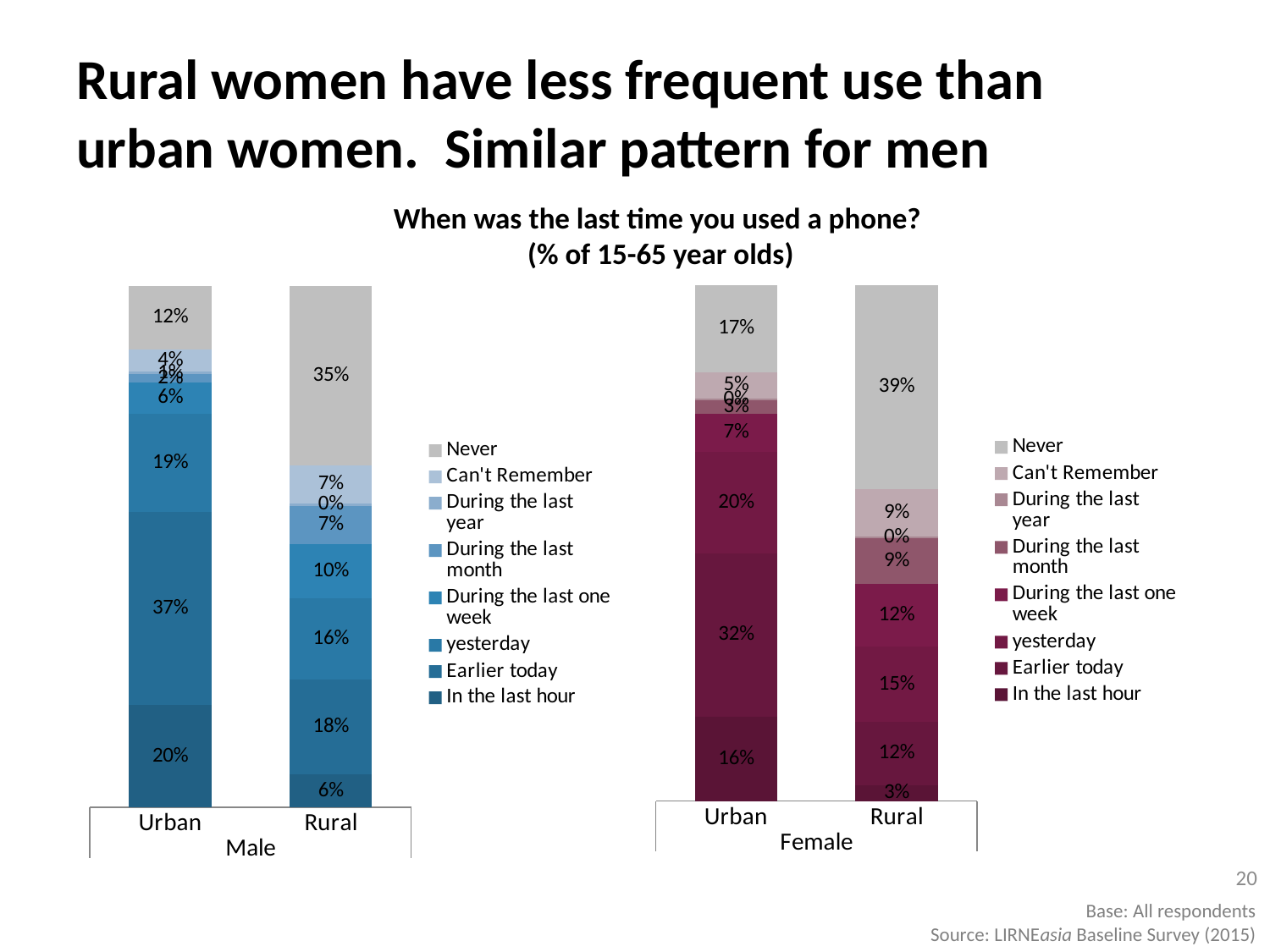
In the Female chart, what is the difference between the 'Never' share for rural women and urban women? 22 percentage points In the Male chart, what is the difference between the 'Earlier today' share for urban men and rural men? 19 percentage points In the Male chart, what percentage of rural men said 'Never'? 35% How many series does the legend of the Female chart list? 8 In the Male chart, what percentage of rural men said 'In the last hour'? 6% In the Male chart, which segment is largest in the Urban bar? Earlier today In the Female chart, what percentage of rural women said 'Never'? 39% What type of chart is used for the Male data? Stacked bar chart What is the title shown above the charts? When was the last time you used a phone? (% of 15-65 year olds) In the Female chart, what percentage of urban women said 'Earlier today'? 32% In the Female chart, is the 'In the last hour' share larger for urban or rural women? Urban In the Male chart, what percentage of urban men said 'Never'? 12%